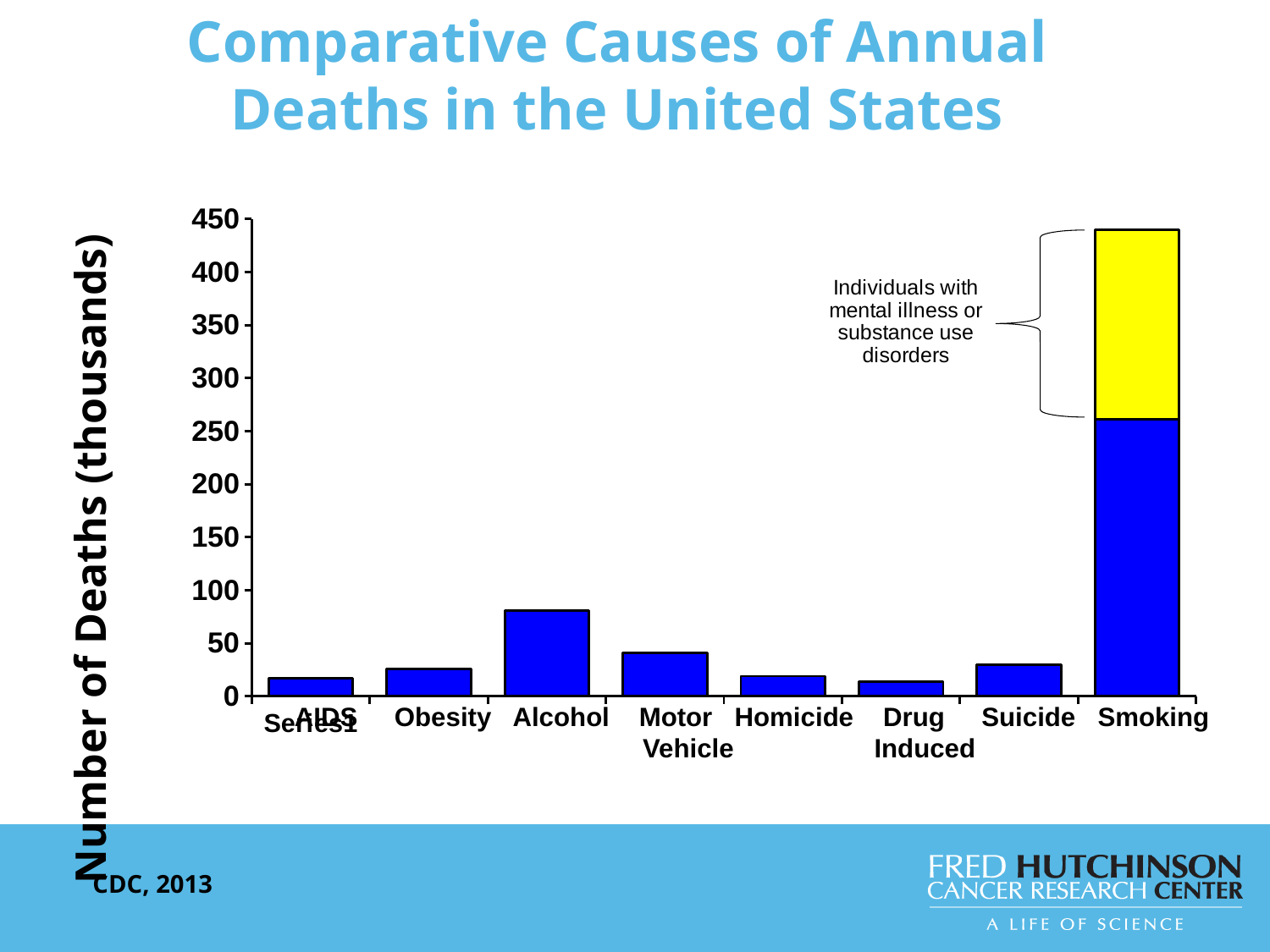
What kind of chart is shown on the slide? bar chart What does the yellow portion of the Smoking bar represent, according to the annotation? Individuals with mental illness or substance use disorders Which cause of death has the highest number of annual deaths? Smoking Is the value for Motor Vehicle greater or less than 50? less Is the value for Alcohol greater or less than 50? greater Which is larger, the value for Alcohol or the value for Motor Vehicle? Alcohol How many causes of death are shown on the x axis? 8 What is the title of the y axis? Number of Deaths (thousands) Is the value for Smoking greater or less than 400? greater Which is larger, the value for Motor Vehicle or the value for Suicide? Motor Vehicle